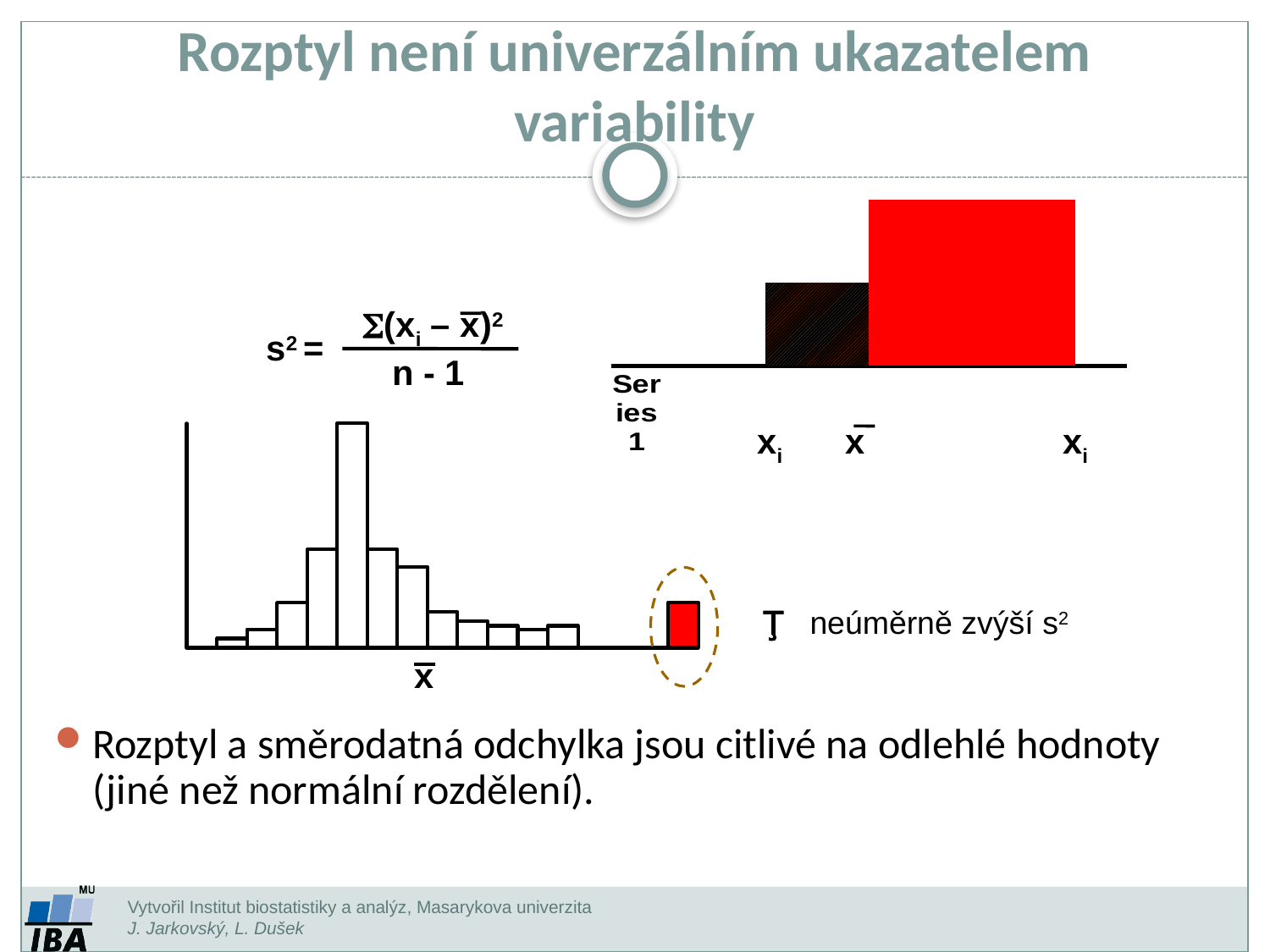
How many bars does the upper-right bar chart contain? 2 In the lower histogram-style chart, what colour is the isolated outlier bar on the far right? red What series name is printed below the axis of the upper-right bar chart? Series 1 In the lower histogram-style chart, is the red outlier bar taller or shorter than the tallest white bar? shorter In the upper-right bar chart, which bar is taller, the red bar or the hatched black bar? the red bar In the upper-right bar chart, what colour is the taller bar? red In the lower histogram-style chart, do the white bars rise or fall moving from the tallest bar toward the right? fall What kind of chart is shown in the upper right of the slide? bar chart